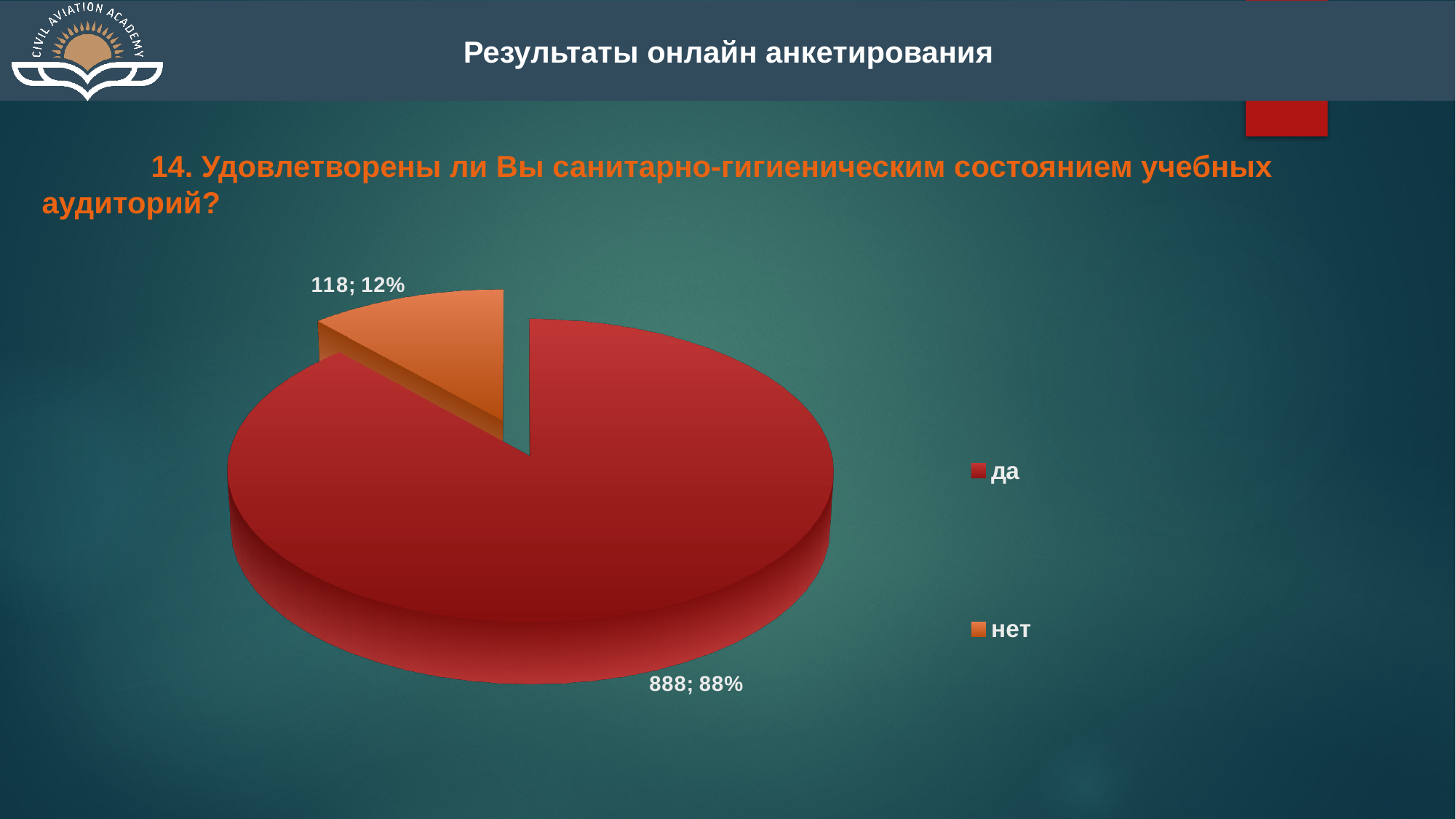
How many respondents answered "да"? 888 How many respondents answered "нет"? 118 What colour is the "нет" slice in the pie chart? orange What is the difference between the number of "да" and "нет" responses? 770 How many slices does the pie chart have? 2 What kind of chart is shown on the slide? pie chart What share of the pie does the "нет" slice represent? 12% What is the total number of responses shown in the pie chart? 1006 Which answer has the largest slice of the pie? да What share of the pie does the "да" slice represent? 88% Which is larger, the number of "да" responses or the number of "нет" responses? да Which answer has the smallest slice of the pie? нет